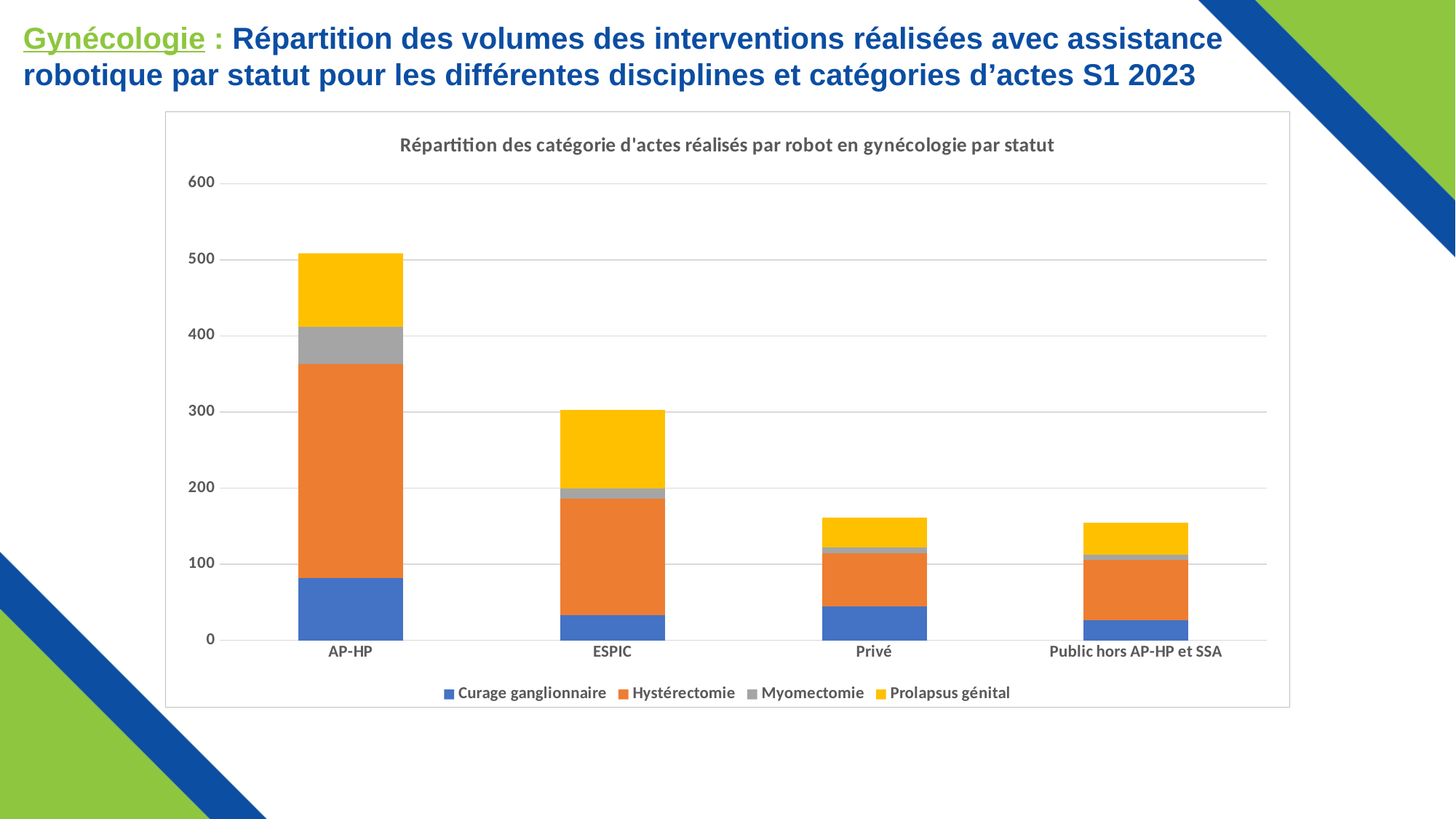
How many series does the chart legend list? 4 Which total bar is larger, AP-HP or ESPIC? AP-HP Is the total bar for AP-HP greater or less than 400? greater Which category has the highest total bar in the chart? AP-HP What kind of chart is shown on the slide? stacked bar chart What is the title of the chart? Répartition des catégorie d'actes réalisés par robot en gynécologie par statut How many categories (statuts) are shown on the x axis of the chart? 4 Is the Curage ganglionnaire value for AP-HP greater or less than 100? less Is the total bar for Privé greater or less than 200? less Which series is shown in yellow in the chart legend? Prolapsus génital